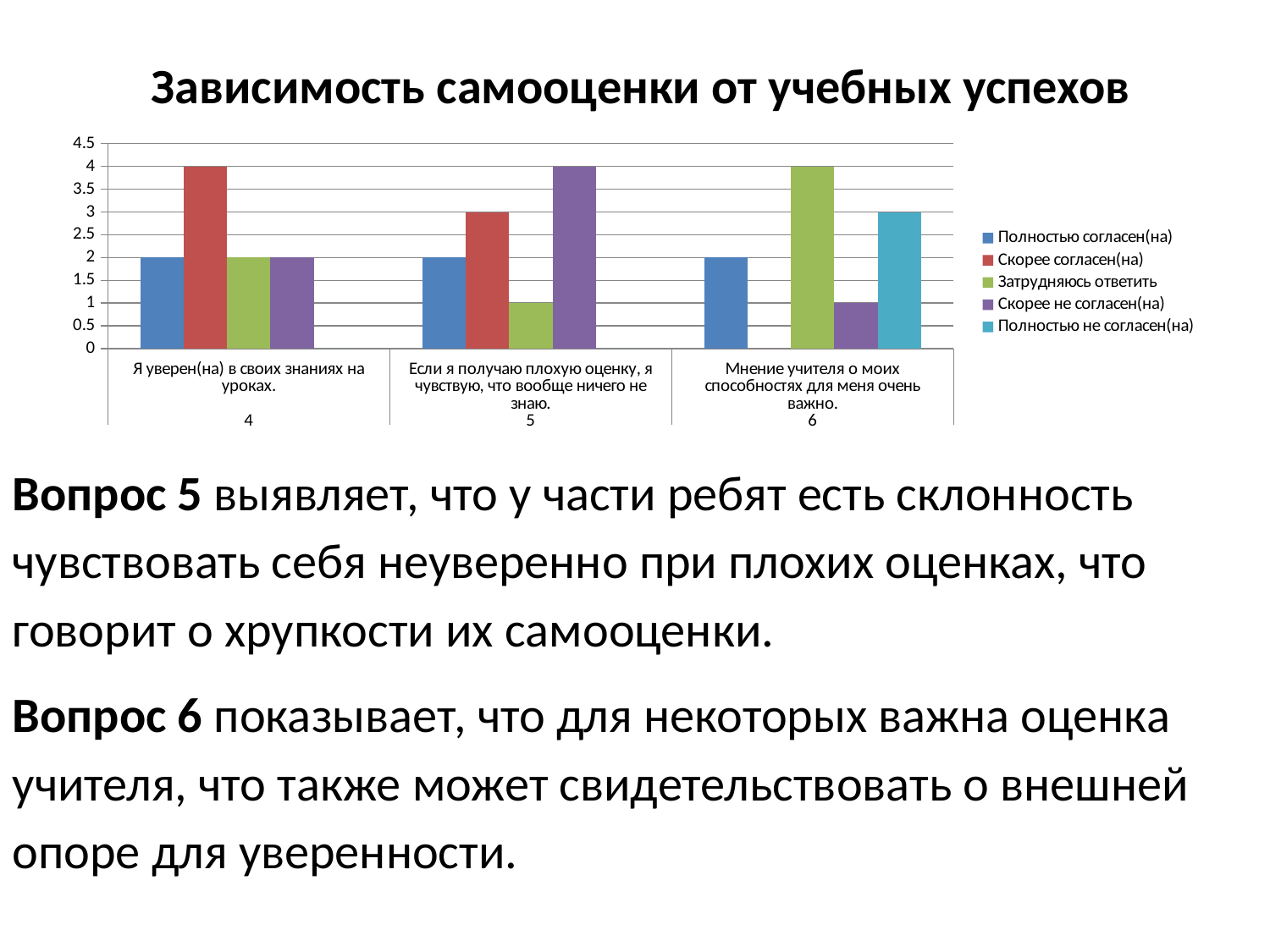
What is the difference between "Скорее согласен(на)" and "Затрудняюсь ответить" for question 5? 2 What is the value for "Скорее согласен(на)" for question 4 ("Я уверен(на) в своих знаниях на уроках.")? 4 What is the title of the chart? Зависимость самооценки от учебных успехов Which series has the lowest visible bar for question 6? Скорее не согласен(на) What is the value for "Полностью не согласен(на)" for question 6? 3 What is the value for "Скорее не согласен(на)" for question 5 ("Если я получаю плохую оценку, я чувствую, что вообще ничего не знаю.")? 4 Which series has the highest value for question 5? Скорее не согласен(на) For question 4, which is larger: "Скорее согласен(на)" or "Полностью согласен(на)"? Скорее согласен(на) How many question categories are shown on the x axis? 3 How many series does the legend list? 5 What type of chart is shown on the slide? bar chart What is the value for "Затрудняюсь ответить" for question 6 ("Мнение учителя о моих способностях для меня очень важно.")? 4